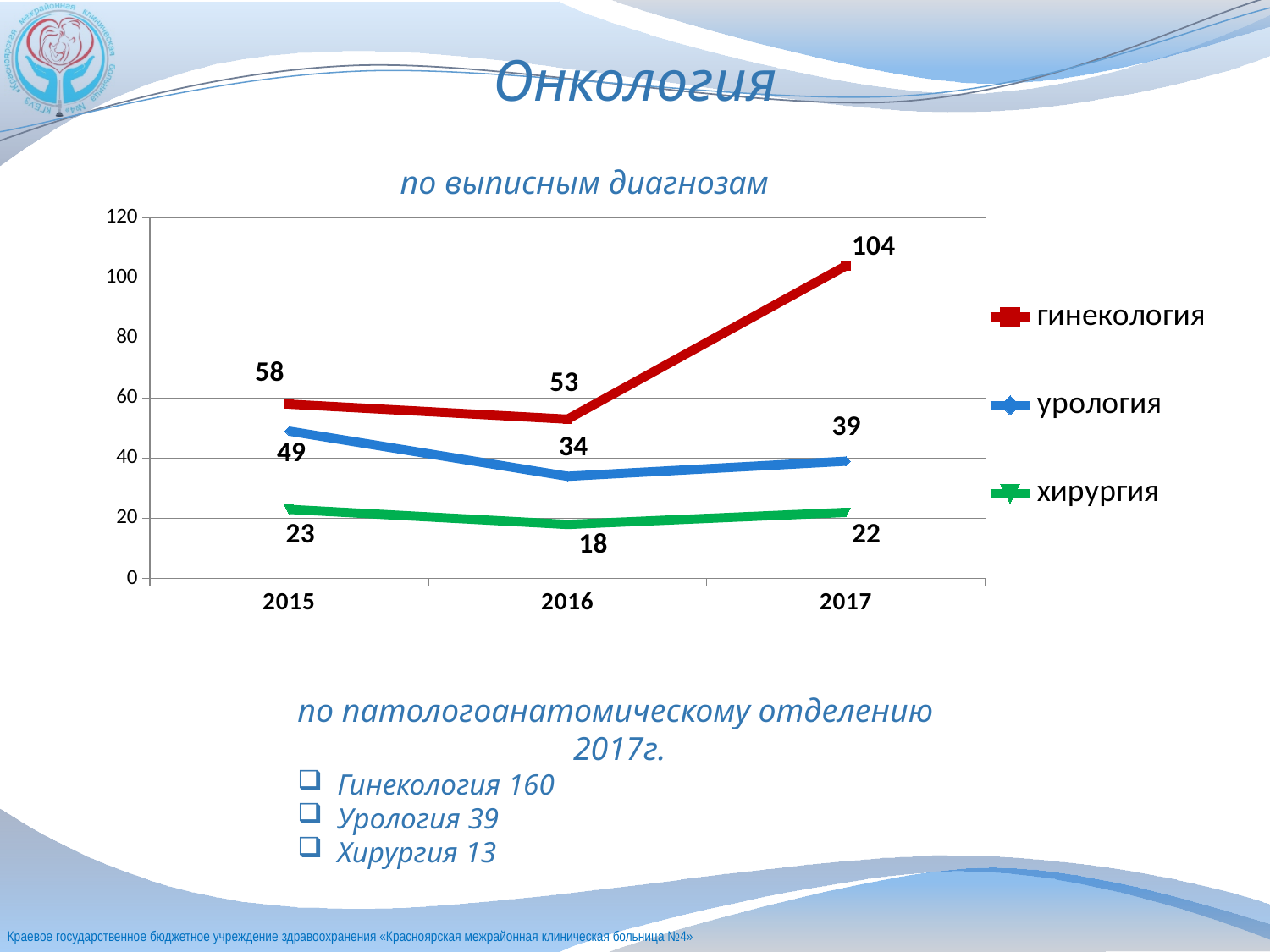
Which is larger in 2015: урология or хирургия? урология What is the value for гинекология in 2017? 104 What is the value for урология in 2016? 34 What is the difference between the гинекология values in 2017 and 2016? 51 What kind of chart is shown? line chart What is the value for хирургия in 2015? 23 How many series does the legend list? 3 In which year is the value for хирургия lowest? 2016 In which year is the value for гинекология highest? 2017 Does the value for урология rise or fall from 2016 to 2017? rise How many years are shown on the x axis? 3 Is the value for гинекология in 2017 greater or less than 100? greater